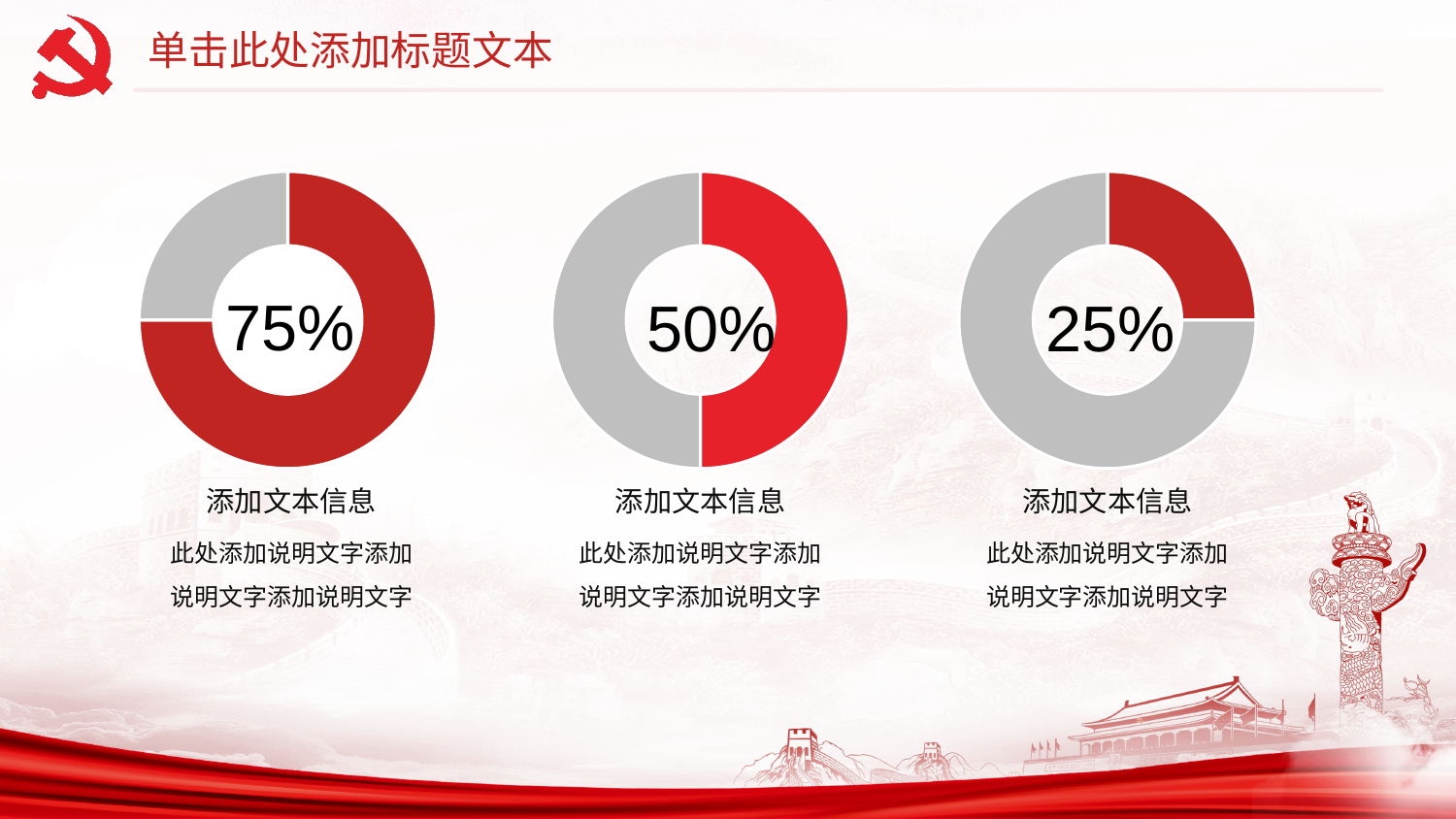
Which of the three donut charts shows the lowest percentage? The right chart (25%) What percentage is shown in the centre of the right donut chart? 25% What is the difference between the percentage in the left donut chart and the percentage in the right donut chart? 50% What is the difference between the percentage in the left donut chart and the percentage in the middle donut chart? 25% What percentage is shown in the centre of the middle donut chart? 50% How many donut charts are on the slide? 3 What kind of chart is used for each of the three figures on the slide? Donut chart Which of the three donut charts shows the highest percentage? The left chart (75%) Is the percentage in the left donut chart larger or smaller than the percentage in the right donut chart? Larger What colour is used for the filled (highlighted) portion of each donut chart? Red In the left donut chart, what share of the ring is grey (not red)? 25% What percentage is shown in the centre of the left donut chart? 75%